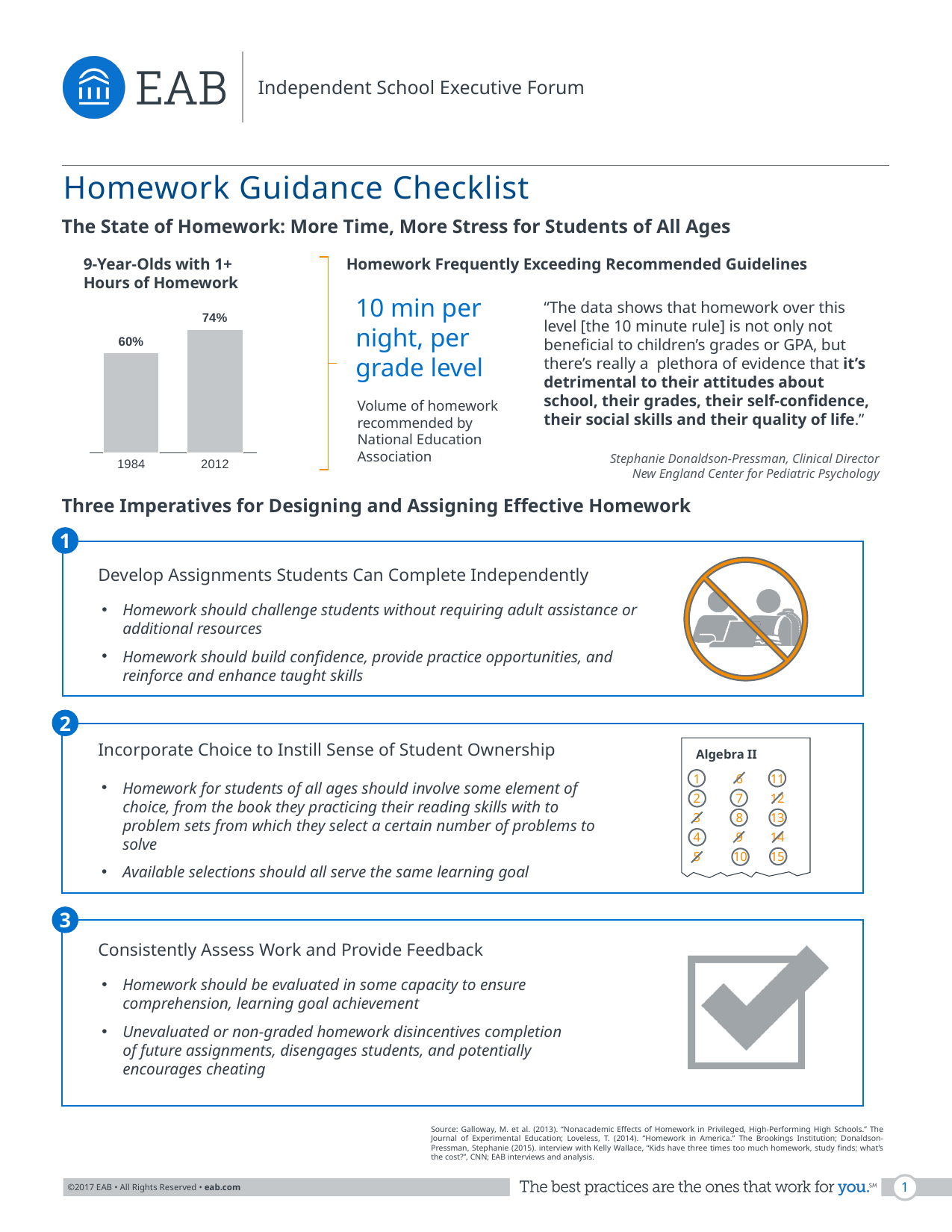
What is the difference between the 2012 and 1984 values in the "9-Year-Olds with 1+ Hours of Homework" chart? 14% What colour are the bars in the "9-Year-Olds with 1+ Hours of Homework" chart? Gray Which year has the higher value in the "9-Year-Olds with 1+ Hours of Homework" chart? 2012 How many bars are shown in the "9-Year-Olds with 1+ Hours of Homework" chart? 2 Do the values in the "9-Year-Olds with 1+ Hours of Homework" chart rise or fall from 1984 to 2012? Rise Which year has the lower value in the "9-Year-Olds with 1+ Hours of Homework" chart? 1984 What is the value for 1984 in the "9-Year-Olds with 1+ Hours of Homework" chart? 60% What kind of chart is the "9-Year-Olds with 1+ Hours of Homework" chart? Bar chart What is the title of the bar chart on the slide? 9-Year-Olds with 1+ Hours of Homework What is the value for 2012 in the "9-Year-Olds with 1+ Hours of Homework" chart? 74% In the "9-Year-Olds with 1+ Hours of Homework" chart, is the value for 1984 or 2012 larger? 2012